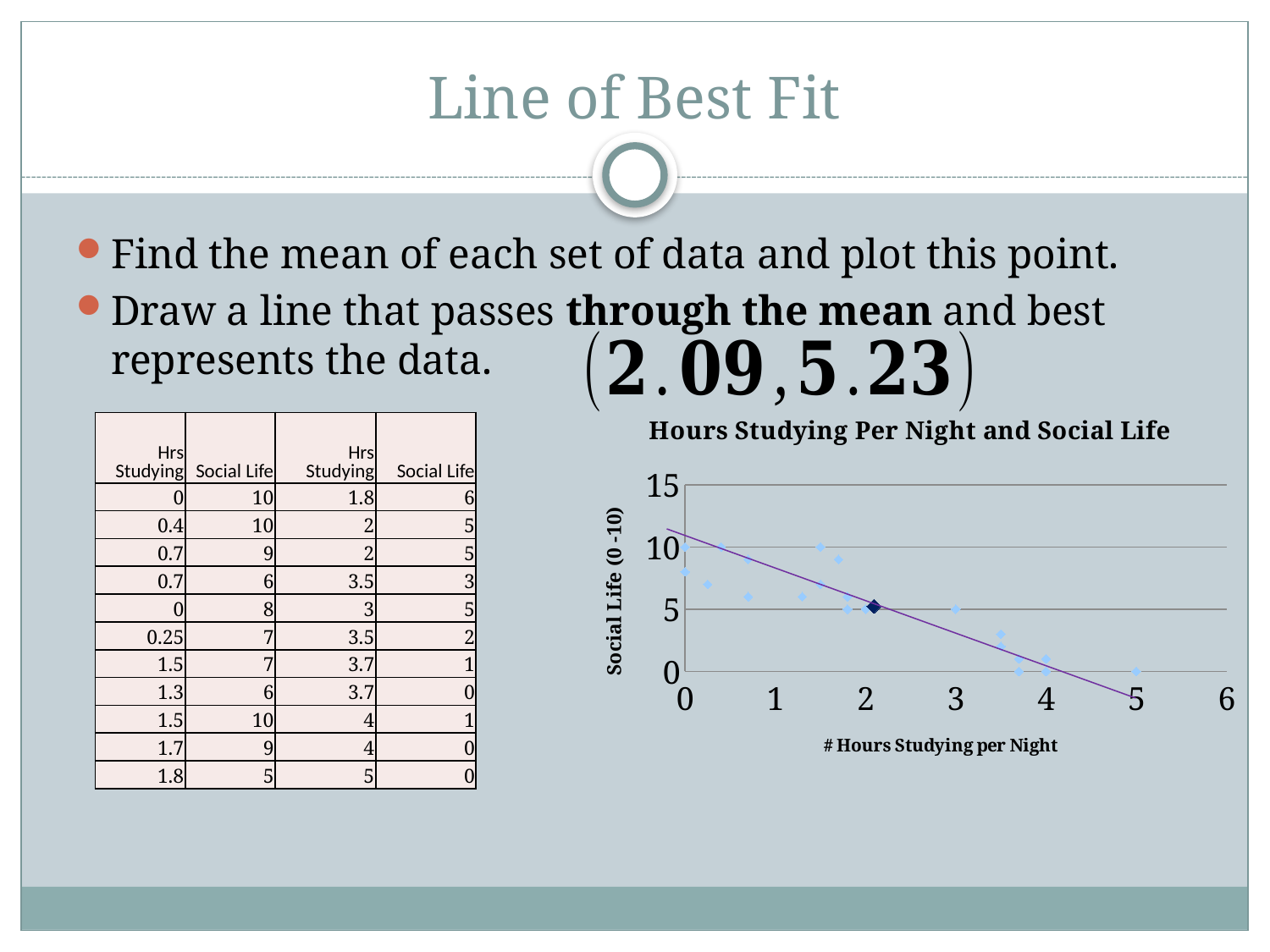
According to the table, which is larger: the social life value for 0.4 hours studying or for 3.5 hours studying? 0.4 hours studying As the number of hours studying per night increases, do the social life values rise or fall? fall According to the table, what is the social life value when hours studying is 5? 0 Is the social life value plotted at 5 hours studying per night greater or less than 5? less How many data points are listed in the table on the slide? 22 What is the highest tick value shown on the vertical axis of the chart? 15 What are the coordinates of the mean point that the line of best fit passes through? (2.09, 5.23) What kind of chart is shown on the slide? scatter chart What is the title of the chart? Hours Studying Per Night and Social Life What is the highest tick value shown on the horizontal axis of the chart? 6 Is the highest social life value plotted at 0 hours studying per night greater or less than 5? greater What is the label of the vertical axis of the chart? Social Life (0 -10)